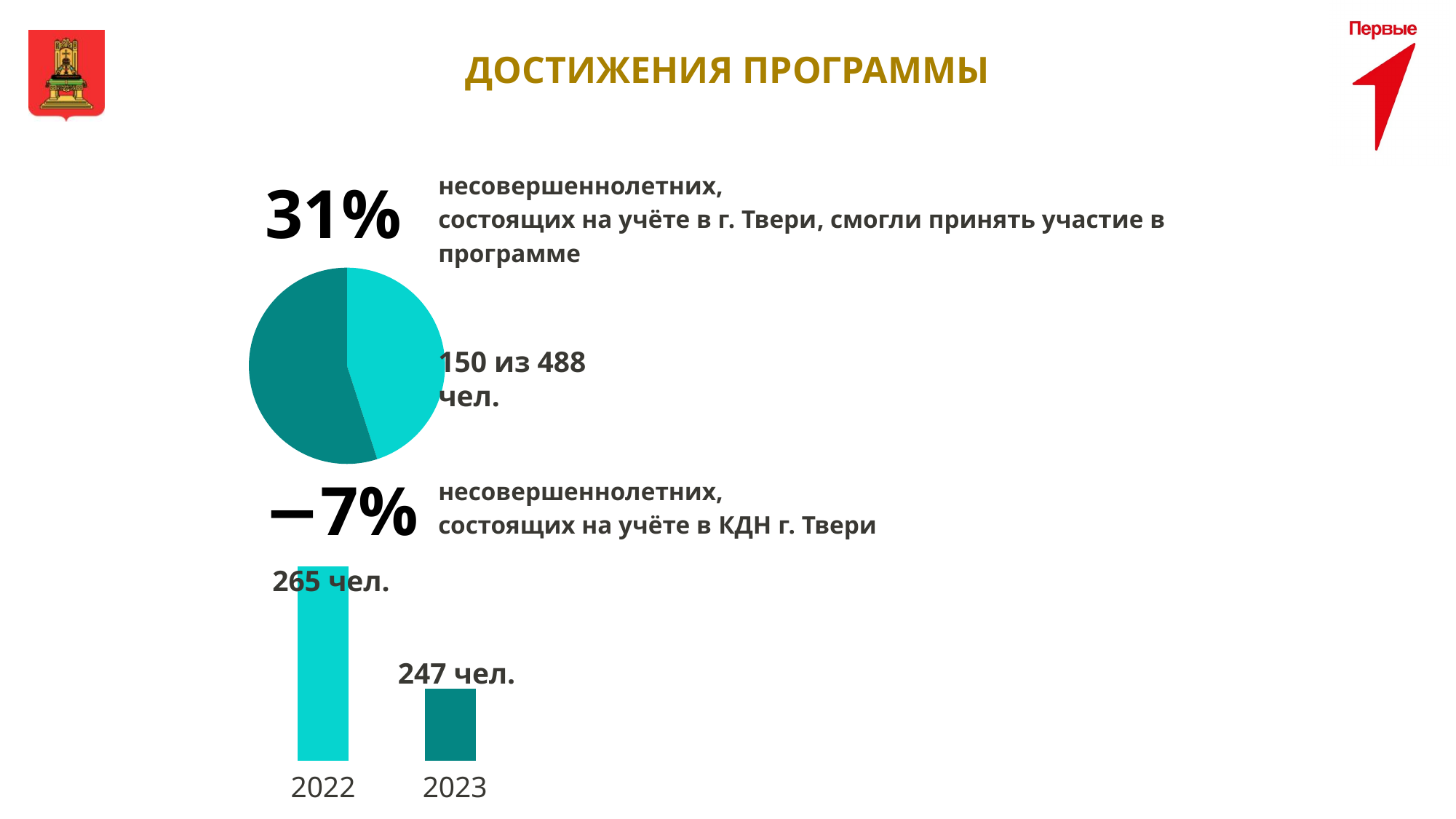
What kind of chart is shown in the upper part of the slide? pie chart In the bar chart at the bottom of the slide, do the values rise or fall from 2022 to 2023? fall What percentage is printed above the pie chart in the upper part of the slide? 31% In the bar chart at the bottom of the slide, which year has the higher value? 2022 What kind of chart is shown at the bottom of the slide? bar chart How many bars are in the bar chart at the bottom of the slide? 2 In the bar chart at the bottom of the slide, what is the difference between the 2022 and 2023 values? 18 чел. In the bar chart at the bottom of the slide, what is the value for 2022? 265 чел. In the bar chart at the bottom of the slide, which year has the lower value? 2023 In the bar chart at the bottom of the slide, is the value for 2023 larger or smaller than the value for 2022? smaller What percentage change is printed above the bar chart at the bottom of the slide? −7% In the bar chart at the bottom of the slide, what is the value for 2023? 247 чел.